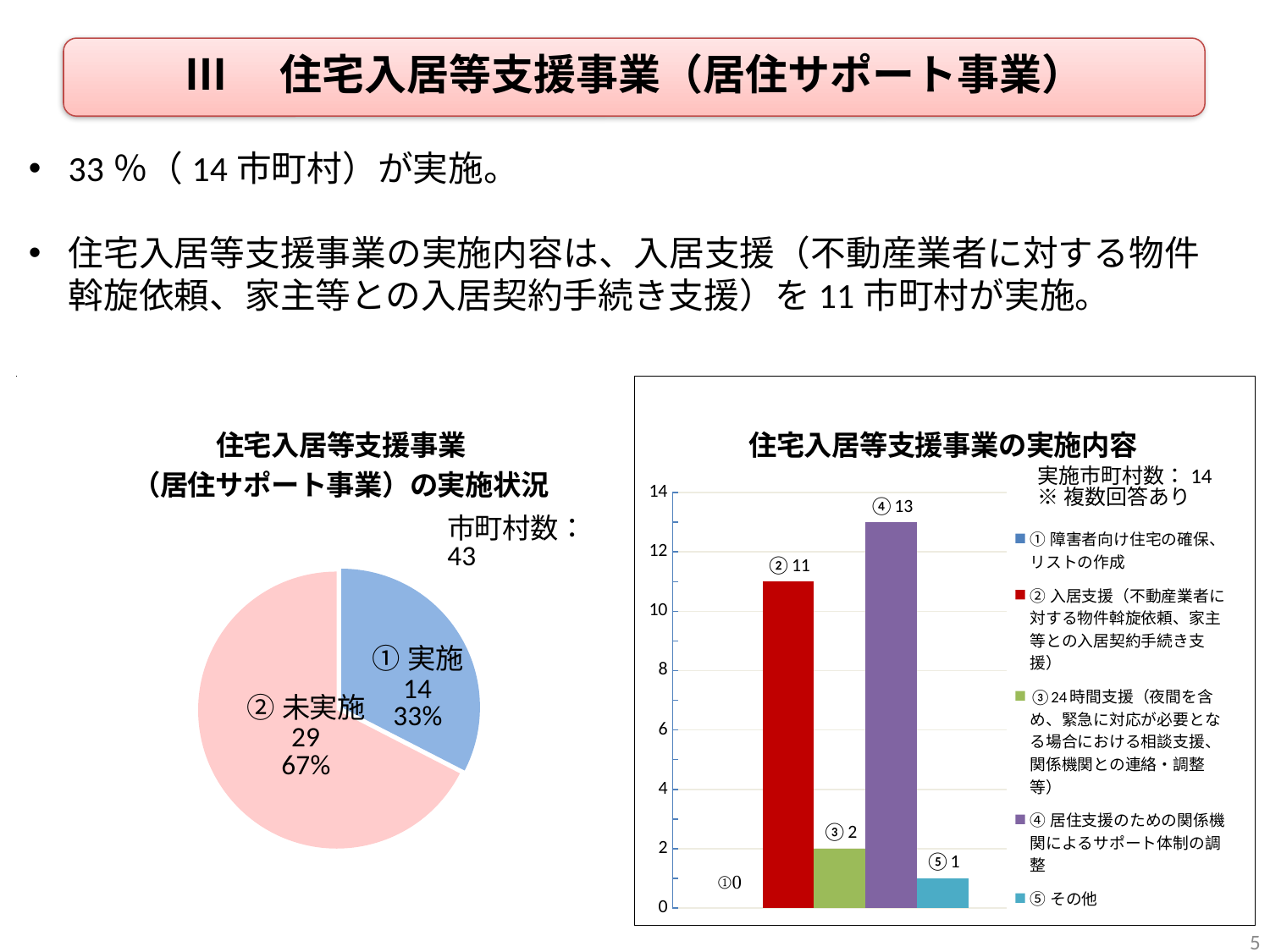
In the right bar chart, which category has the highest value? ④ 居住支援のための関係機関によるサポート体制の調整 In the right bar chart, which category has the lowest value? ① 障害者向け住宅の確保、リストの作成 In the left pie chart, what is the value for ① 実施? 14 In the left pie chart, which slice is larger, ① 実施 or ② 未実施? ② 未実施 In the right bar chart, what is the value for ② 入居支援? 11 In the right bar chart, what is the value for ③ 24時間支援? 2 In the right bar chart, how many series does the legend list? 5 In the left chart (住宅入居等支援事業（居住サポート事業）の実施状況), what kind of chart is shown? pie chart In the left pie chart, what is the difference between the values for ② 未実施 and ① 実施? 15 In the left pie chart, what share of the pie does ② 未実施 represent? 67% In the right chart (住宅入居等支援事業の実施内容), what kind of chart is shown? bar chart In the right bar chart, what is the difference between the values for ④ and ②? 2